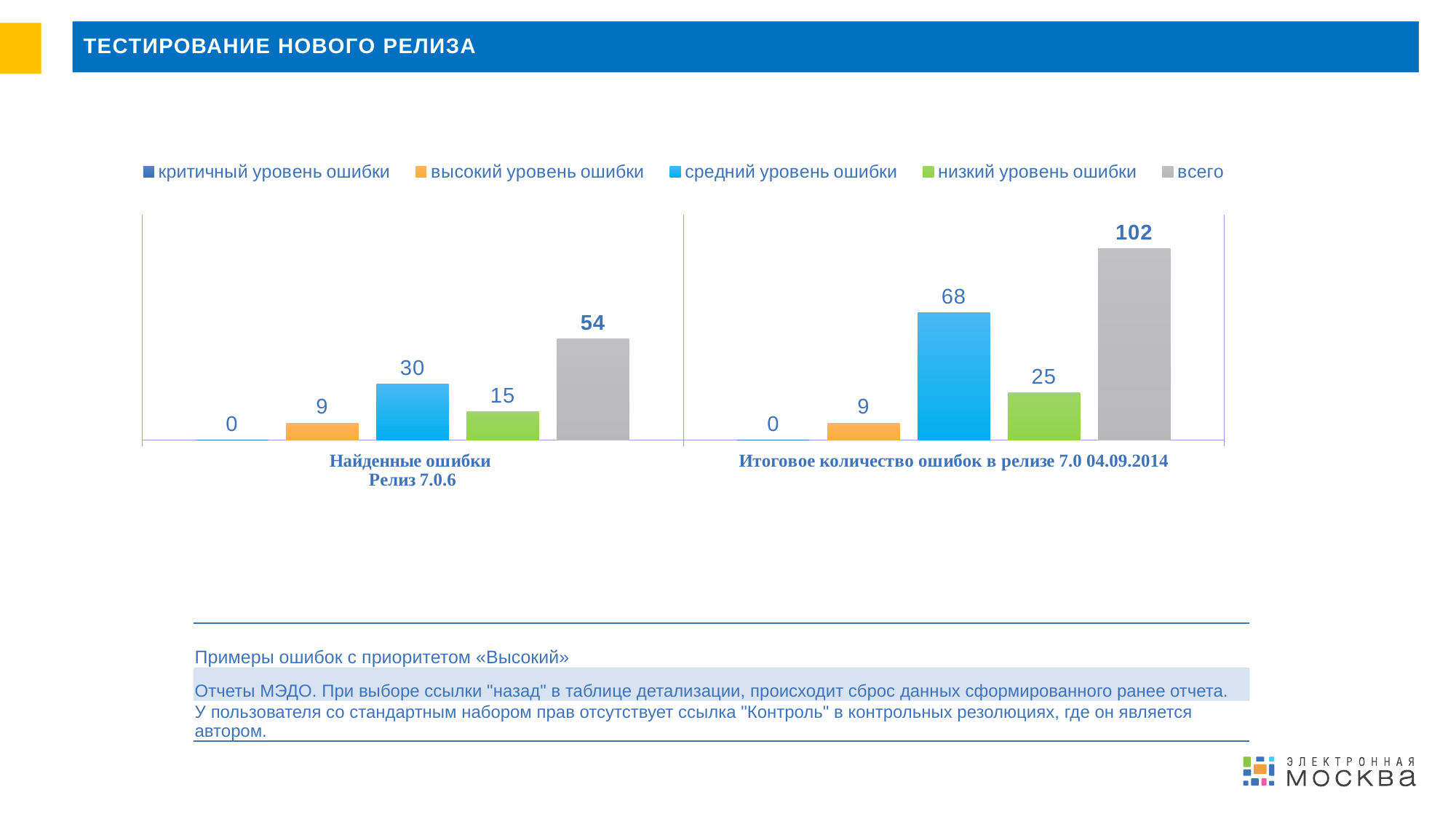
What is the value of 'средний уровень ошибки' for 'Найденные ошибки Релиз 7.0.6'? 30 How many categories are shown on the x axis? 2 How many series does the legend list? 5 Which is larger: 'средний уровень ошибки' for 'Найденные ошибки Релиз 7.0.6' or 'низкий уровень ошибки' for 'Итоговое количество ошибок в релизе 7.0 04.09.2014'? средний уровень ошибки for Найденные ошибки Релиз 7.0.6 What is the value of 'критичный уровень ошибки' for 'Найденные ошибки Релиз 7.0.6'? 0 Which series has the highest value for 'Итоговое количество ошибок в релизе 7.0 04.09.2014'? всего What kind of chart is shown on the slide? bar chart What is the difference between the 'всего' values for 'Итоговое количество ошибок в релизе 7.0 04.09.2014' and 'Найденные ошибки Релиз 7.0.6'? 48 What is the value of 'всего' for 'Итоговое количество ошибок в релизе 7.0 04.09.2014'? 102 What colour are the 'всего' bars? grey What is the value of 'низкий уровень ошибки' for 'Итоговое количество ошибок в релизе 7.0 04.09.2014'? 25 Which series has the lowest value for 'Найденные ошибки Релиз 7.0.6'? критичный уровень ошибки